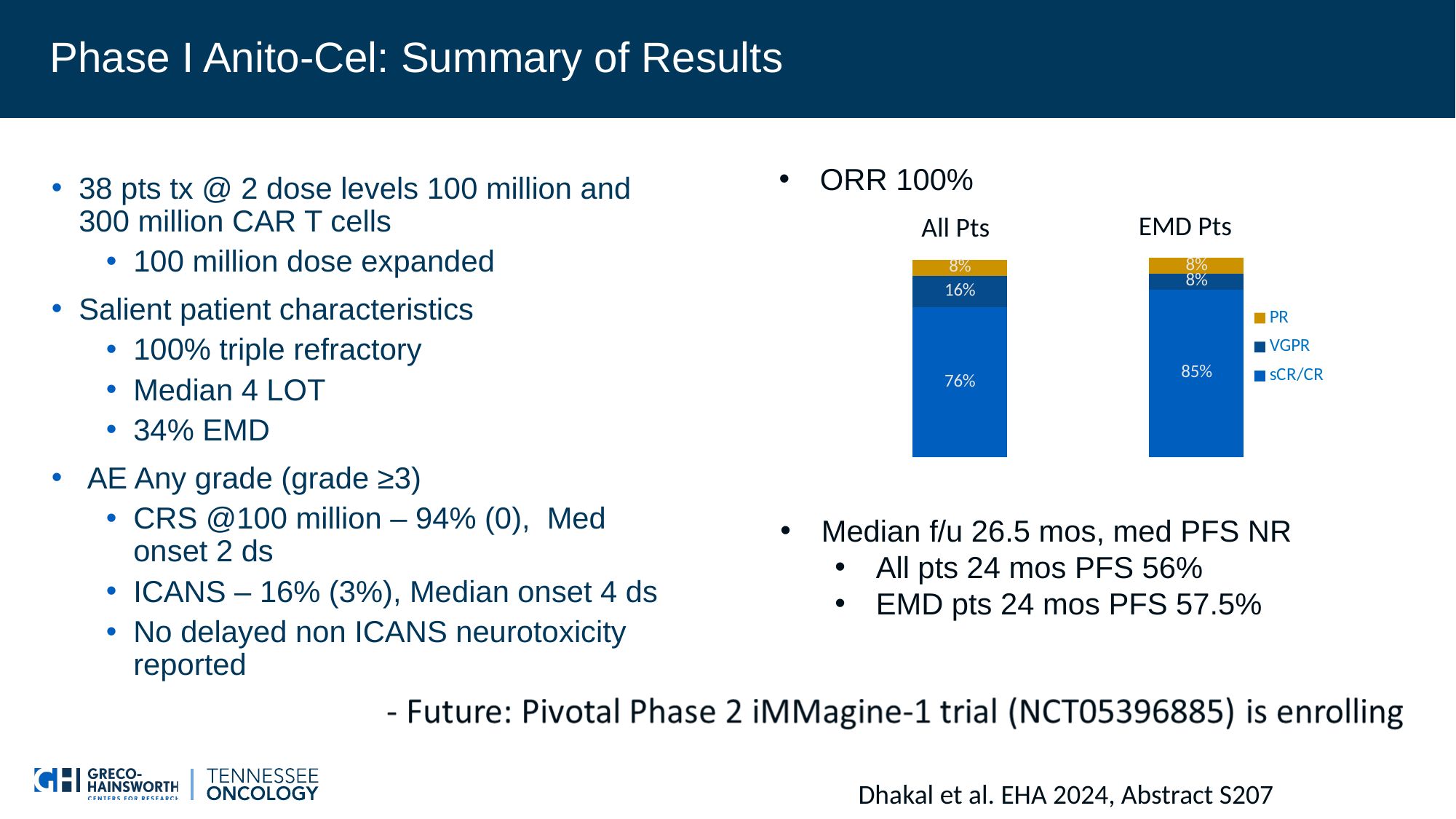
What is the VGPR value for All Pts? 16% What is the difference between the VGPR values for All Pts and EMD Pts? 8% What is the sCR/CR value for EMD Pts? 85% What kind of chart is shown on the slide? Stacked bar chart What is the difference between the sCR/CR values for EMD Pts and All Pts? 9% What is the sCR/CR value for All Pts? 76% What is the PR value for EMD Pts? 8% Which series is shown in gold/yellow in the chart legend? PR How many series does the chart legend list? 3 What is the VGPR value for EMD Pts? 8% How many groups (bars) are shown in the chart? 2 Which group has the higher sCR/CR value, All Pts or EMD Pts? EMD Pts